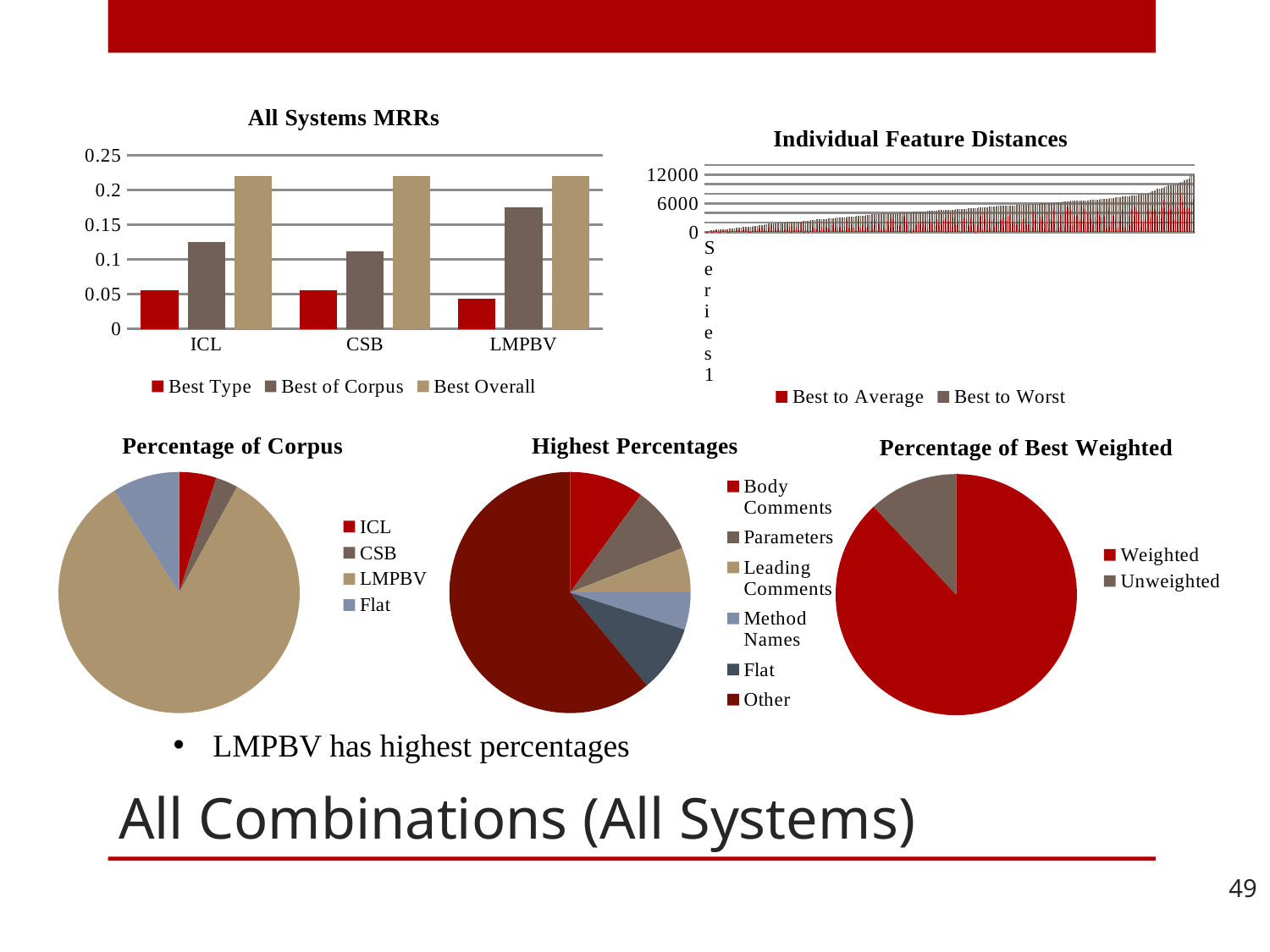
In the 'All Systems MRRs' chart, is the Best Overall value for ICL greater or less than 0.2? greater In the 'Individual Feature Distances' chart, how many series does the legend list? 2 In the 'All Systems MRRs' chart, which category has the highest Best of Corpus value? LMPBV In the 'All Systems MRRs' chart, is the Best of Corpus value for LMPBV greater or less than 0.15? greater In the 'Percentage of Corpus' pie chart, which category has the largest slice? LMPBV In the 'Individual Feature Distances' chart, do the values rise or fall along the x axis? rise In the 'Percentage of Best Weighted' pie chart, which slice is larger: Weighted or Unweighted? Weighted In the 'All Systems MRRs' chart, which is larger for CSB: Best Type or Best of Corpus? Best of Corpus In the 'All Systems MRRs' chart, how many series does the legend list? 3 In the 'All Systems MRRs' chart, which category has the lowest Best Type value? LMPBV What kind of chart is the 'All Systems MRRs' chart? bar chart In the 'All Systems MRRs' chart, how many categories are shown on the x axis? 3